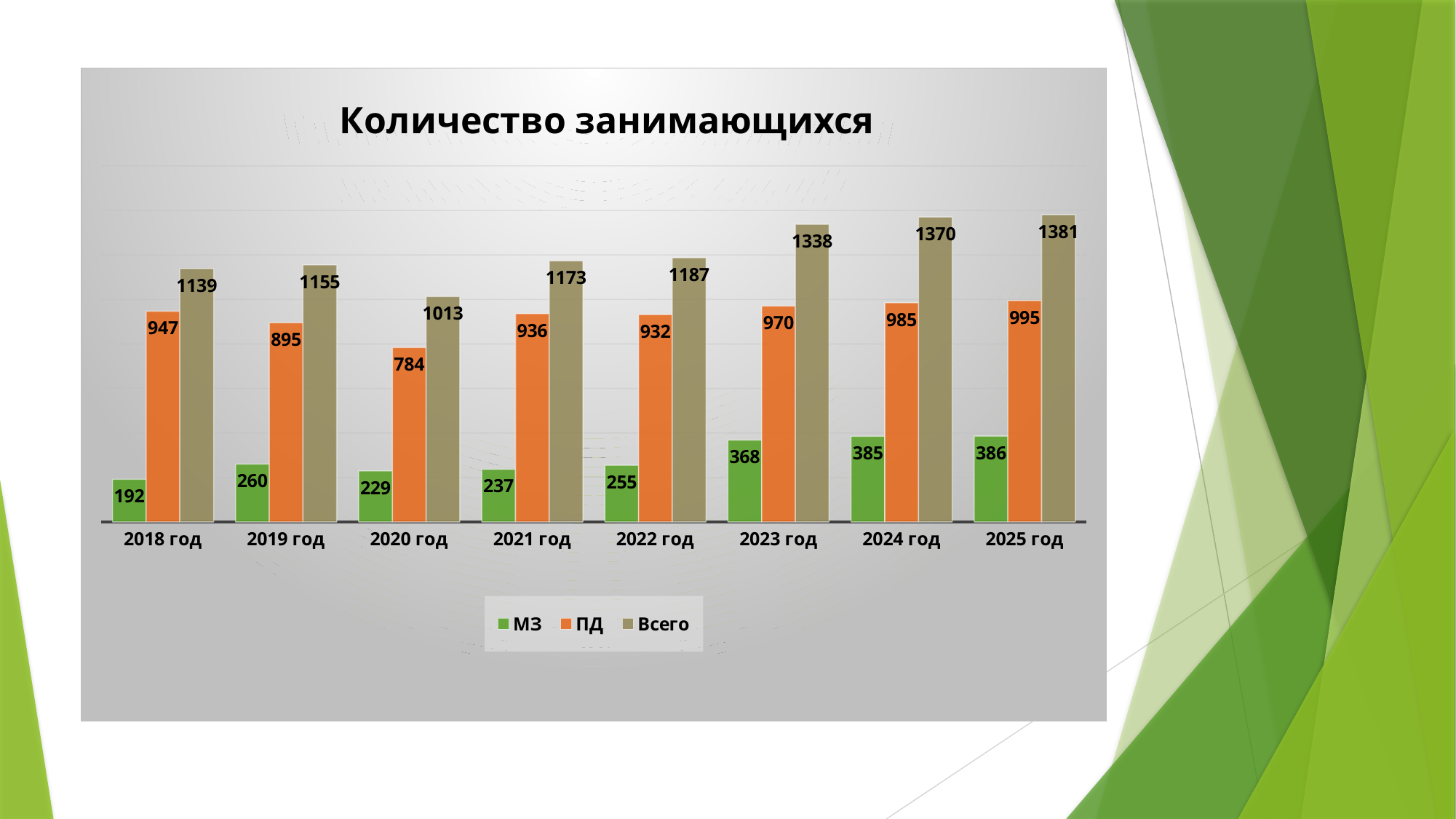
Which year has the lowest МЗ value? 2018 год What is the value of Всего for 2024 год? 1370 What is the value of МЗ for 2018 год? 192 What is the value of ПД for 2020 год? 784 What is the title of the chart? Количество занимающихся How many years are shown on the x axis? 8 How many series does the legend list? 3 Which year has the highest Всего value? 2025 год Which is larger: ПД for 2019 год or ПД for 2021 год? ПД for 2021 год Do the Всего values rise or fall from 2020 год to 2025 год? Rise What is the difference between the Всего values for 2025 год and 2018 год? 242 What kind of chart is this? Bar chart